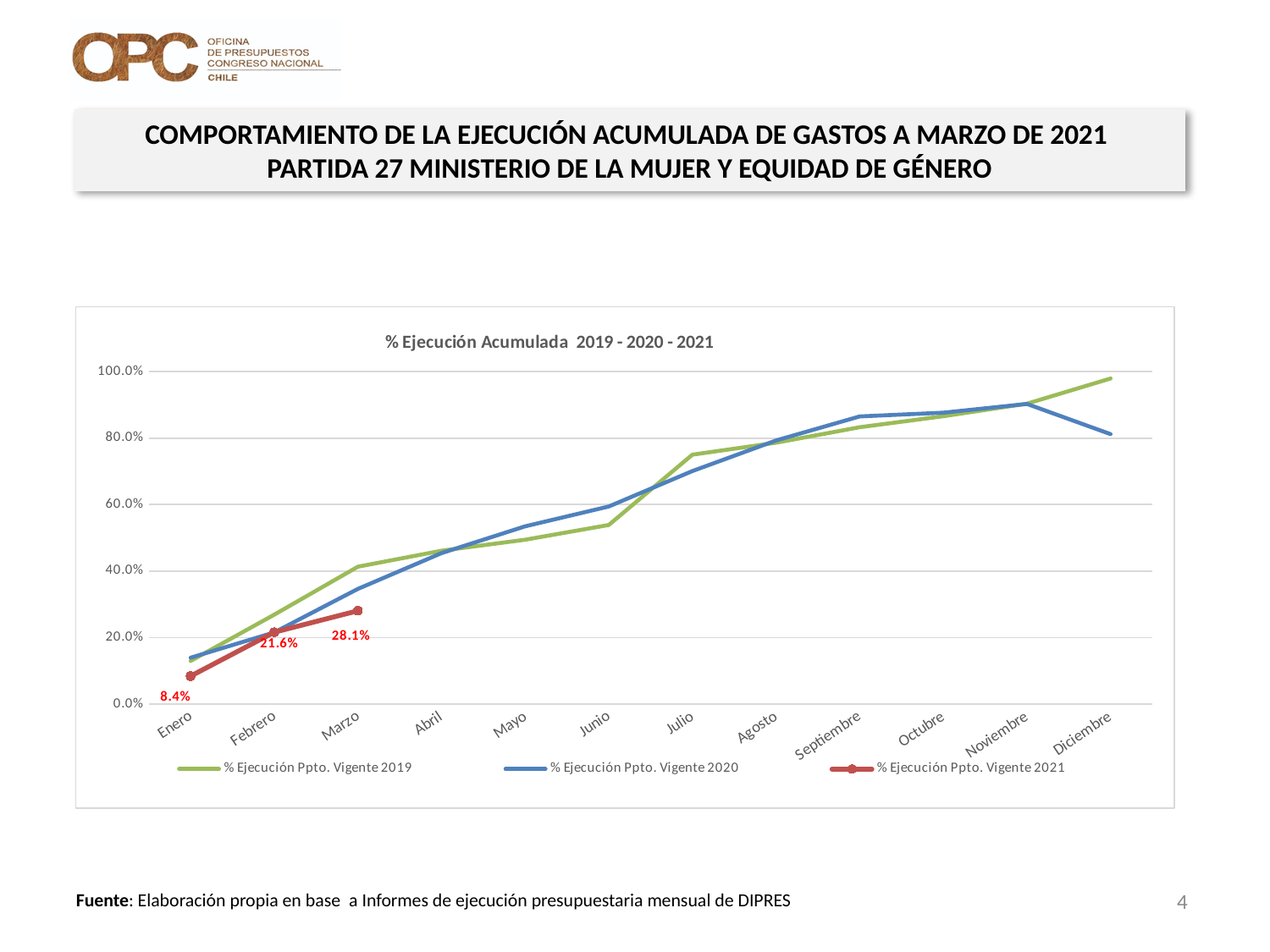
How many months are shown on the x axis of the chart? 12 Does the % Ejecución Ppto. Vigente 2021 series rise or fall from Enero to Marzo? Rise What is the value of % Ejecución Ppto. Vigente 2021 for Marzo? 28.1% Which month has the highest value for the % Ejecución Ppto. Vigente 2021 series? Marzo What kind of chart is shown on the slide? Line chart Is the value for % Ejecución Ppto. Vigente 2019 in Diciembre greater or less than 80.0%? greater What is the value of % Ejecución Ppto. Vigente 2021 for Enero? 8.4% What is the value of % Ejecución Ppto. Vigente 2021 for Febrero? 21.6% How many series does the legend of the chart list? 3 In Diciembre, which series has the higher value: % Ejecución Ppto. Vigente 2019 or % Ejecución Ppto. Vigente 2020? % Ejecución Ppto. Vigente 2019 What is the title of the chart? % Ejecución Acumulada 2019 - 2020 - 2021 By how many percentage points does the 2021 value for Marzo exceed the 2021 value for Enero? 19.7